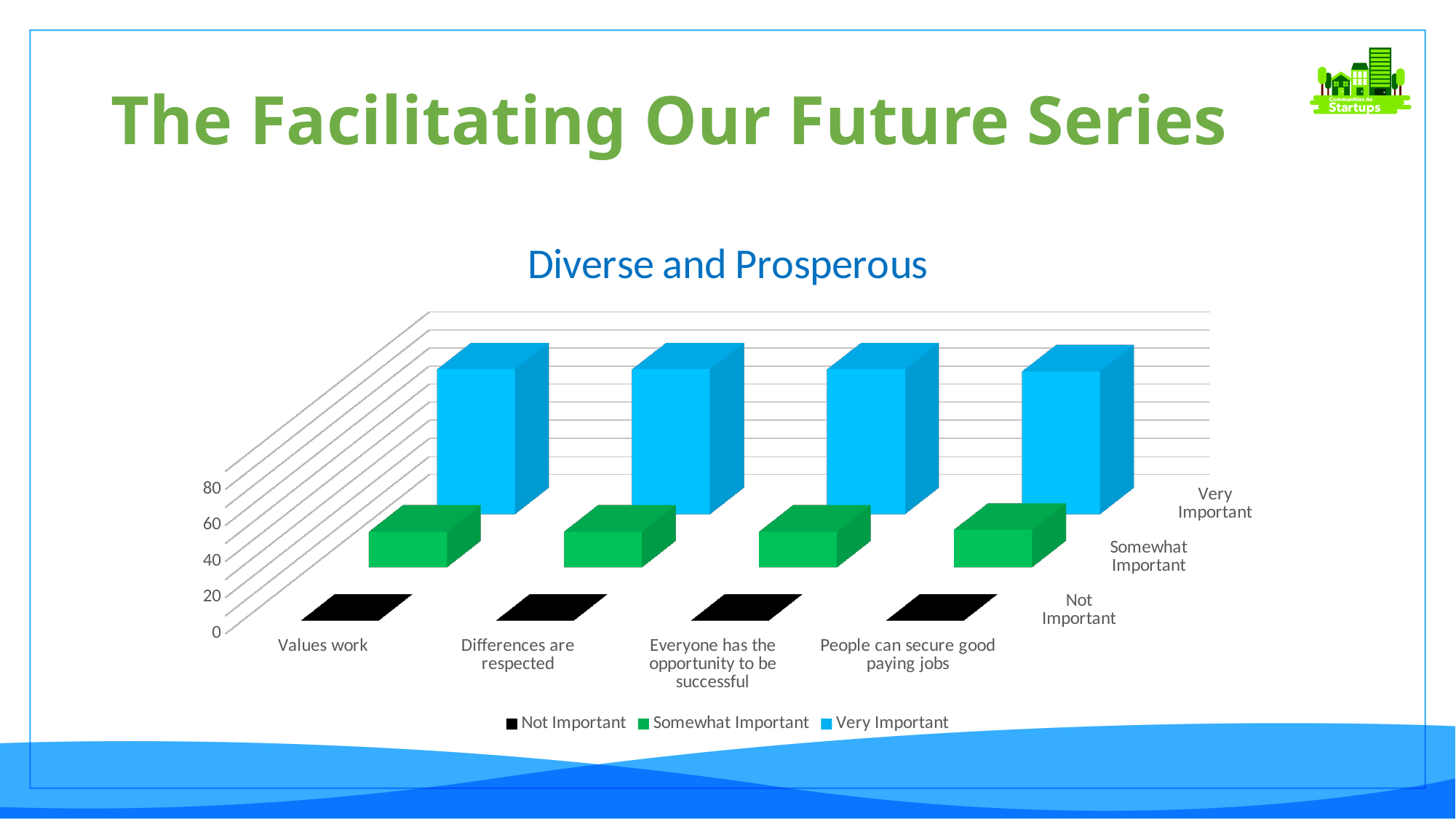
How many categories are shown along the x axis? 4 Is the Not Important value for 'Values work' greater or less than 20? less Which series has the highest values across all categories? Very Important Is the Not Important value for 'Everyone has the opportunity to be successful' greater or less than 20? less How many series does the legend list? 3 Which series is shown in blue in the legend? Very Important What kind of chart is shown on the slide? bar chart For 'People can secure good paying jobs', which is larger: Very Important or Not Important? Very Important What is the title of the chart? Diverse and Prosperous For 'Values work', which is larger: Very Important or Somewhat Important? Very Important For 'Differences are respected', which is larger: Somewhat Important or Not Important? Somewhat Important Which series has the lowest values across all categories? Not Important